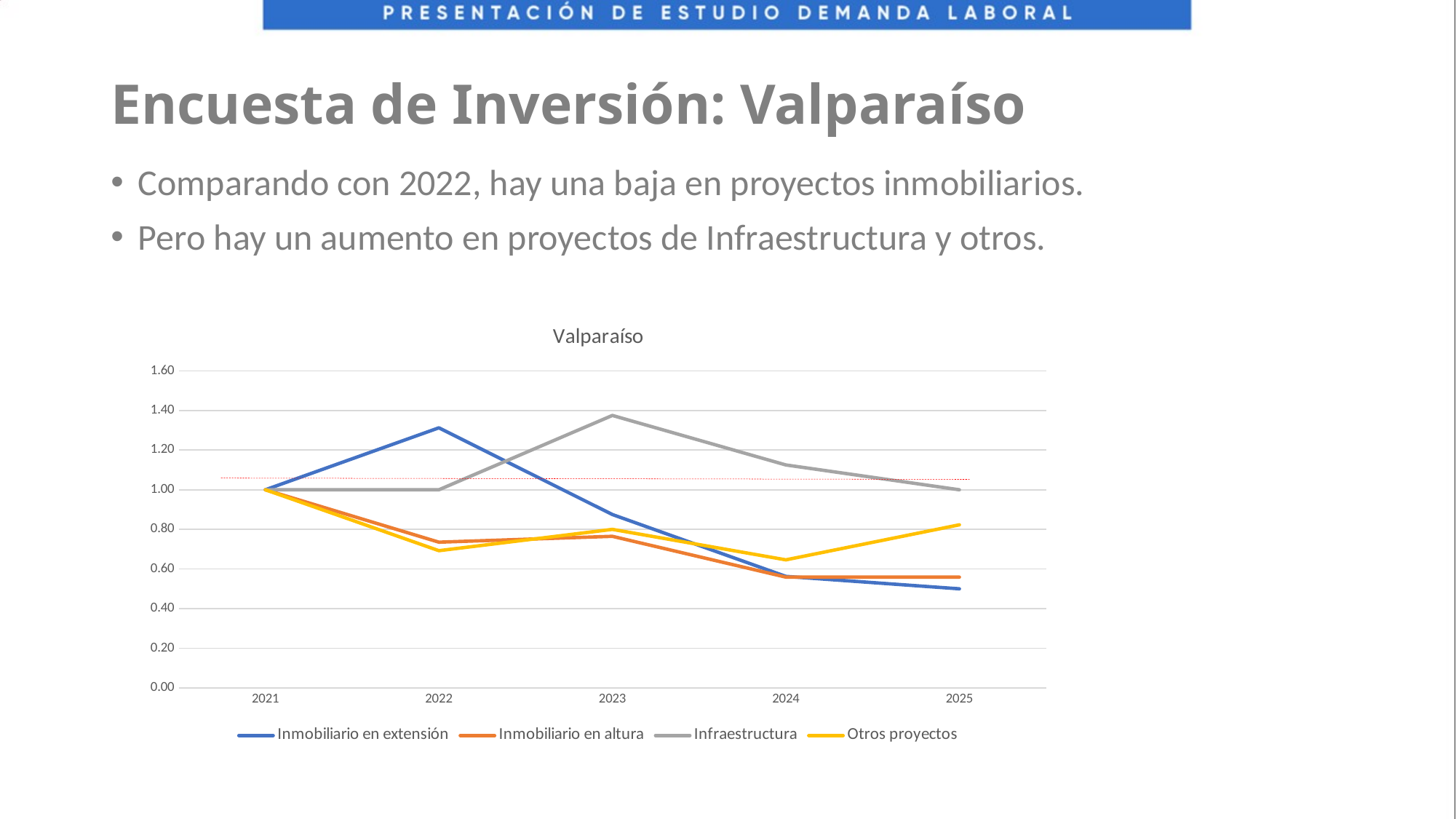
Is the value for Inmobiliario en extensión in 2022 greater or less than 1.20? greater What is the title of the chart? Valparaíso What is the value of Infraestructura in 2022? 1.00 Which series has the lowest value in 2025? Inmobiliario en extensión Does the Inmobiliario en extensión line rise or fall from 2022 to 2025? fall How many series does the legend of the Valparaíso chart list? 4 Which series has the highest value in 2022? Inmobiliario en extensión Which series has the highest value in 2023? Infraestructura How many years are shown on the x axis of the Valparaíso chart? 5 What type of chart is shown on the slide? line chart What is the value of Infraestructura in 2025? 1.00 Is the value for Inmobiliario en altura in 2022 greater or less than 0.80? less